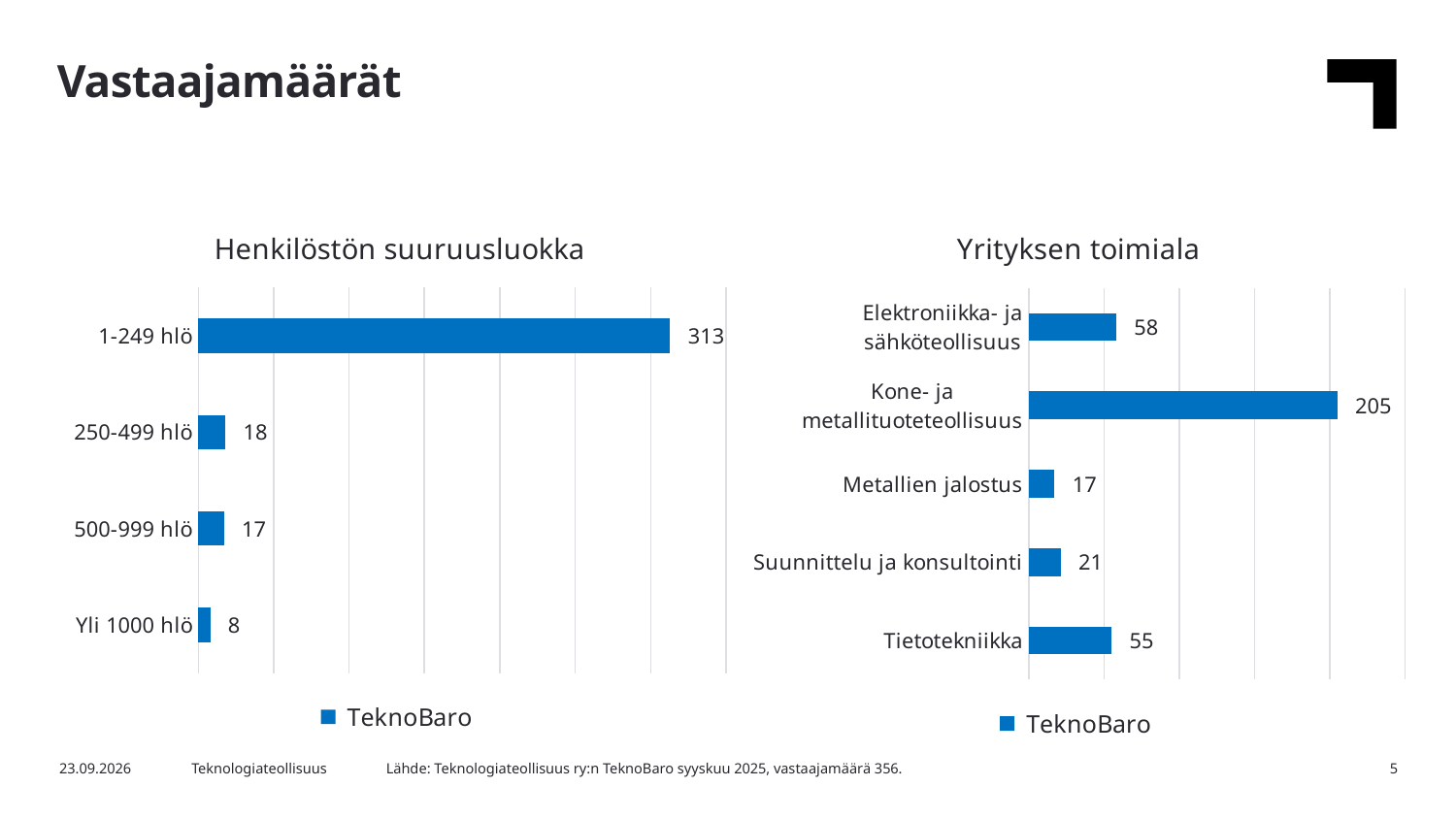
In the 'Yrityksen toimiala' chart, what is the value for Suunnittelu ja konsultointi? 21 In the 'Yrityksen toimiala' chart, what is the value for Kone- ja metallituoteteollisuus? 205 What kind of chart is the 'Yrityksen toimiala' chart? Bar chart In the 'Henkilöstön suuruusluokka' chart, how many categories are shown? 4 In the 'Henkilöstön suuruusluokka' chart, what is the difference between the values for 250-499 hlö and 500-999 hlö? 1 In the 'Henkilöstön suuruusluokka' chart, what is the total of all four categories? 356 In the 'Henkilöstön suuruusluokka' chart, what is the value for 1-249 hlö? 313 In the 'Henkilöstön suuruusluokka' chart, which category has the lowest value? Yli 1000 hlö In the 'Yrityksen toimiala' chart, which category has the highest value? Kone- ja metallituoteteollisuus In the 'Yrityksen toimiala' chart, which is larger: Elektroniikka- ja sähköteollisuus or Tietotekniikka? Elektroniikka- ja sähköteollisuus How many series does the legend of the 'Henkilöstön suuruusluokka' chart list? 1 In the 'Yrityksen toimiala' chart, what is the difference between Kone- ja metallituoteteollisuus and Metallien jalostus? 188